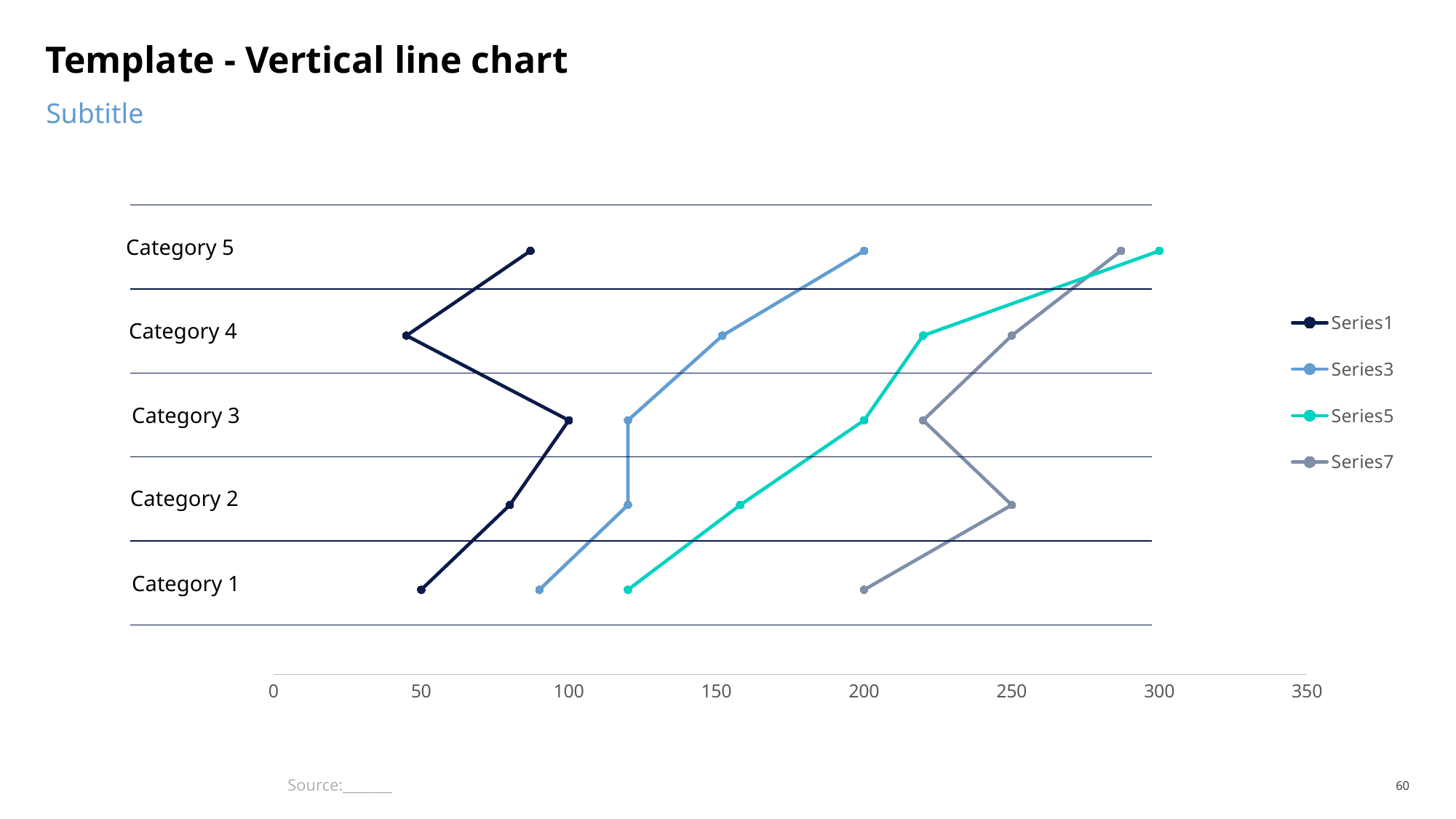
What kind of chart is shown on the slide? line chart What is the value of Series1 for Category 3? 100 Which series has the lowest value for Category 1? Series1 Is the value of Series7 for Category 2 greater or less than 200? greater How many categories are plotted on the chart? 5 What is the value of Series3 for Category 5? 200 Is the value of Series1 for Category 4 greater or less than 50? less What is the value of Series5 for Category 5? 300 For Category 3, which is larger: the value of Series5 or the value of Series3? Series5 How many series does the legend list? 4 Which series has the highest value for Category 5? Series5